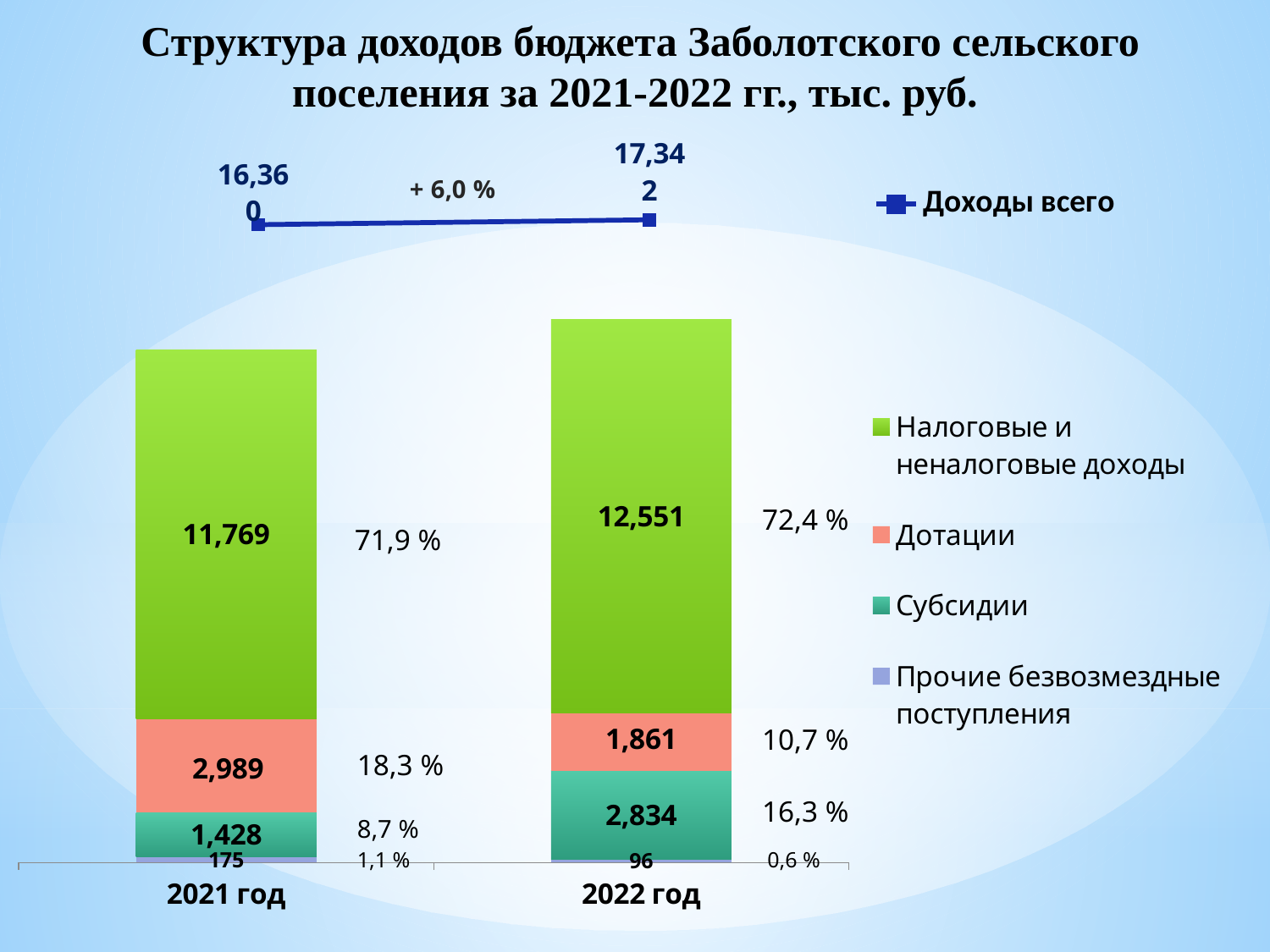
What is the value of Дотации for 2022 год? 1,861 What is the value of Прочие безвозмездные поступления for 2022 год? 96 What is the value of Субсидии for 2021 год? 1,428 What kind of chart is used to show the income structure? Stacked bar chart What is the difference between Дотации in 2021 год and Дотации in 2022 год? 1,128 Which segment is the smallest in the 2022 год bar? Прочие безвозмездные поступления Which is larger: Субсидии in 2021 год or Субсидии in 2022 год? 2022 год What percentage change in total income is shown between 2021 год and 2022 год? + 6,0 % How many series does the legend for the stacked bars list? 4 What is the total income (Доходы всего) shown for 2021 год? 16,360 What percentage share is shown for Налоговые и неналоговые доходы in 2022 год? 72,4 % What is the value of Налоговые и неналоговые доходы for 2021 год? 11,769